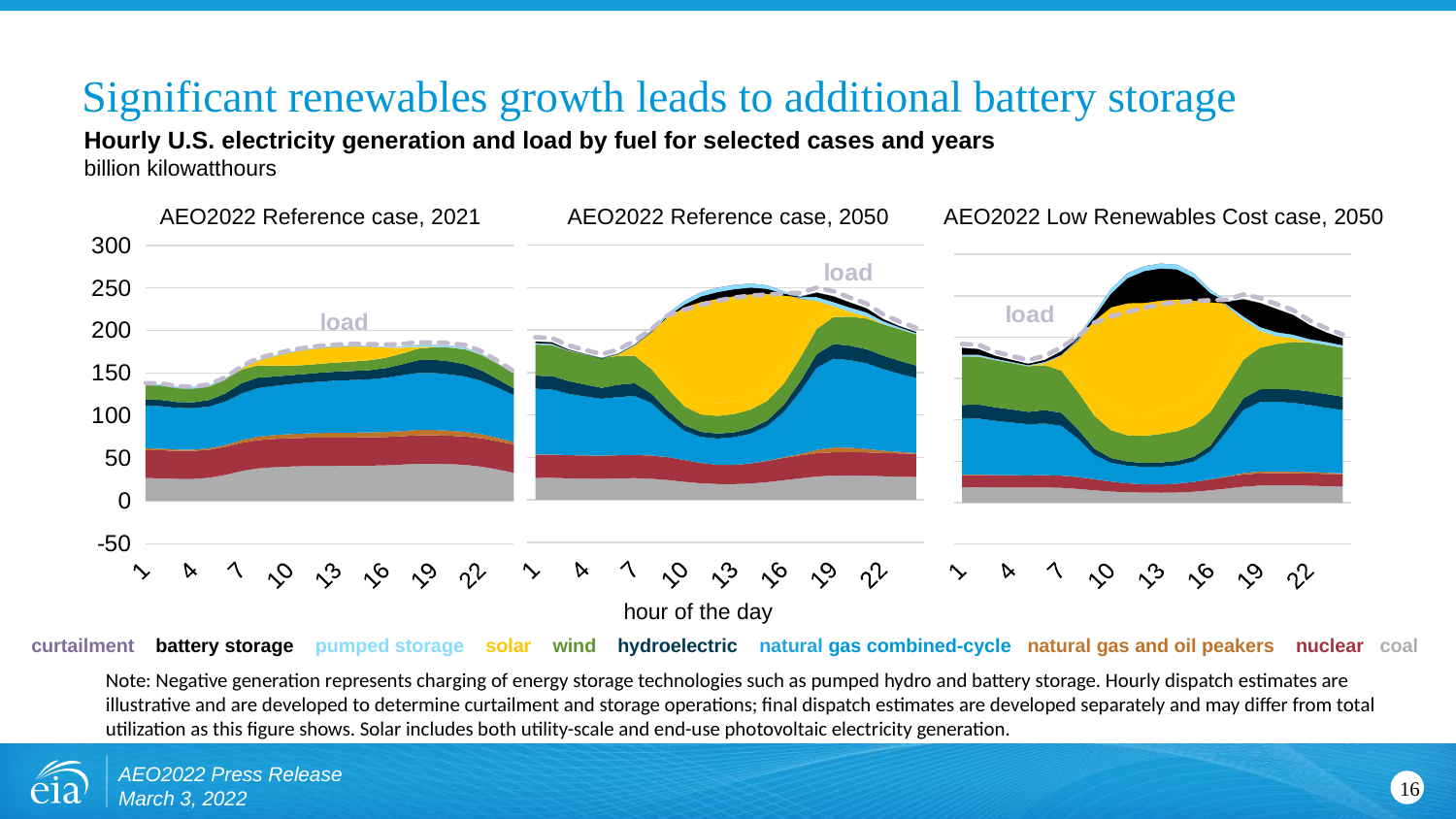
What unit is given for the values on the y axis? billion kilowatthours In the AEO2022 Reference case, 2021 chart, is the peak load value greater or less than 200? less In the AEO2022 Low Renewables Cost case, 2050 chart, is the load at hour 1 greater or less than 200? less Which of the three charts shows the largest battery storage (black) area? AEO2022 Low Renewables Cost case, 2050 What kind of chart is used in each of the three panels on the slide? stacked area chart How many series does the legend list? 10 What is the label of the shared x axis? hour of the day How many separate chart panels are shown on the slide? 3 In the AEO2022 Reference case, 2050 chart, does solar generation rise or fall from hour 13 to hour 19? fall In the AEO2022 Reference case, 2021 chart, is the coal generation at hour 1 greater or less than 50? less In the AEO2022 Reference case, 2021 chart, does the load rise or fall from hour 1 to hour 13? rise